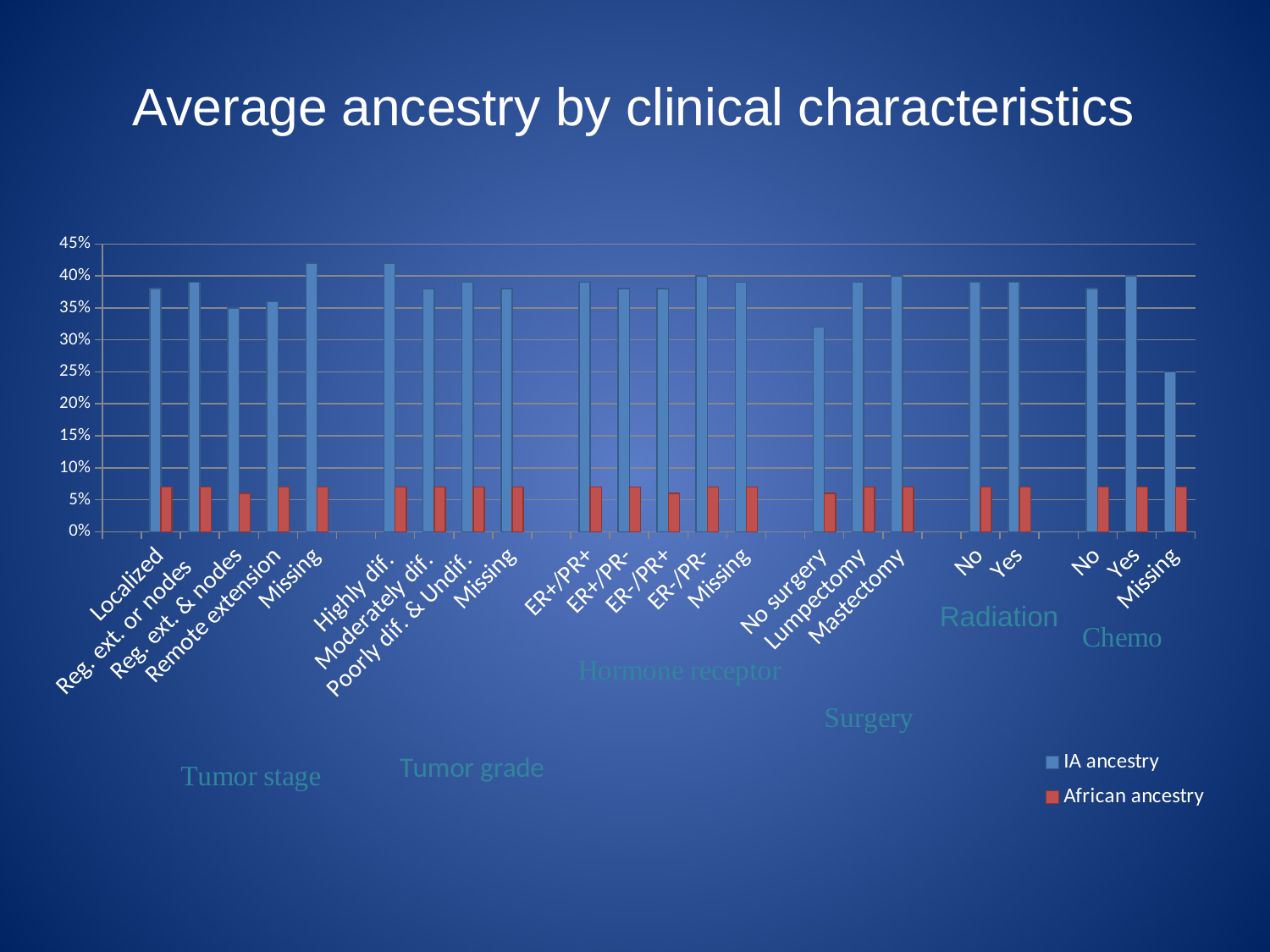
What are the two series named in the legend? IA ancestry and African ancestry Is the IA ancestry value for Missing under Chemo greater or less than 30%? less Is the IA ancestry value for Reg. ext. & nodes greater or less than 40%? less Which category has the lowest IA ancestry value? Missing (Chemo) What is the title of the chart? Average ancestry by clinical characteristics How many series does the legend list? 2 Which has the larger IA ancestry value, Yes under Chemo or Missing under Chemo? Yes What kind of chart is shown on the slide? bar chart Is the African ancestry value for Localized greater or less than 10%? less Which has the larger IA ancestry value, No surgery or Mastectomy? Mastectomy